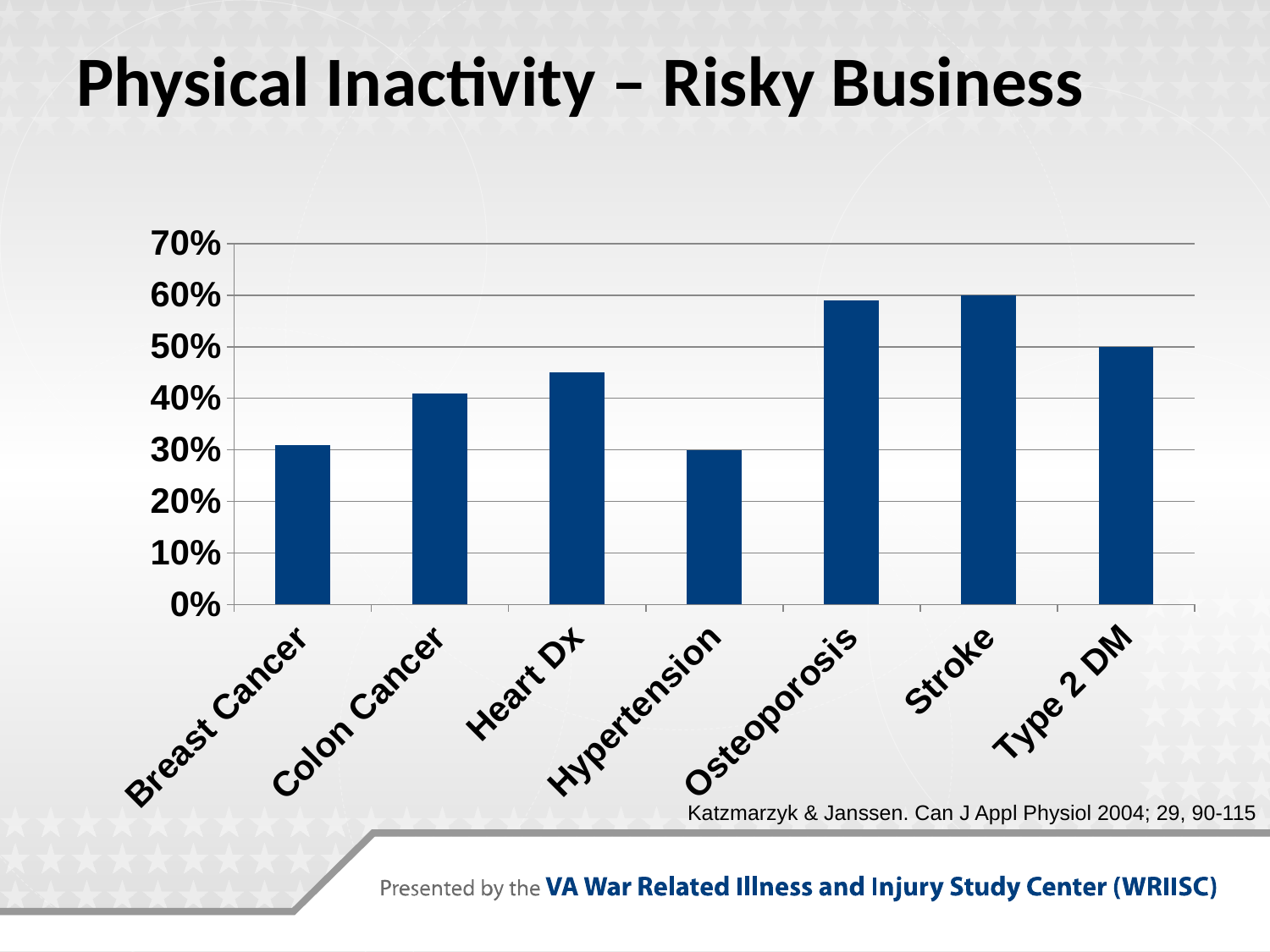
Is the value for Hypertension greater or less than 40%? less What kind of chart is shown on the slide? bar chart What colour are the bars in the chart? dark blue Is the value for Breast Cancer greater or less than 40%? less What is the title of the slide containing the chart? Physical Inactivity – Risky Business What is the value for Stroke? 60% What is the value for Type 2 DM? 50% How many categories are shown on the x axis of the chart? 7 Which is larger, the value for Osteoporosis or the value for Breast Cancer? Osteoporosis Is the value for Heart Dx greater or less than 40%? greater Which is larger, the value for Heart Dx or the value for Hypertension? Heart Dx